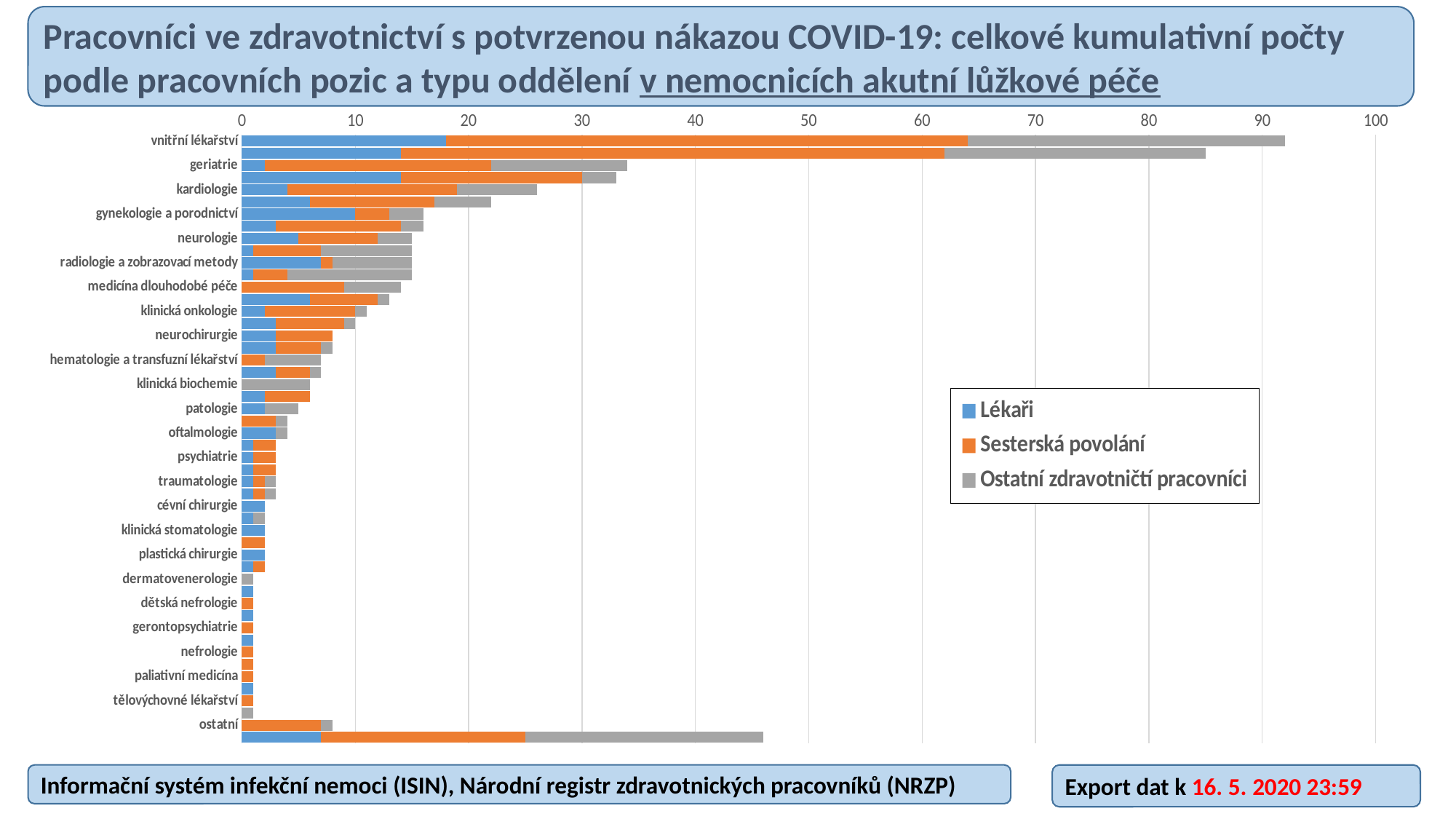
Is the total value for kardiologie greater or less than 30? less Is the total value for geriatrie greater or less than 30? greater What kind of chart is shown on the slide? Stacked bar chart Is the total value for geriatrie greater or less than 40? less Which labelled department has the longest total bar? vnitřní lékařství How many series does the legend list? 3 Which has the larger total bar, vnitřní lékařství or geriatrie? vnitřní lékařství Which has the larger total bar, kardiologie or neurologie? kardiologie Which series is shown in orange in the legend? Sesterská povolání Which series is shown in blue in the legend? Lékaři